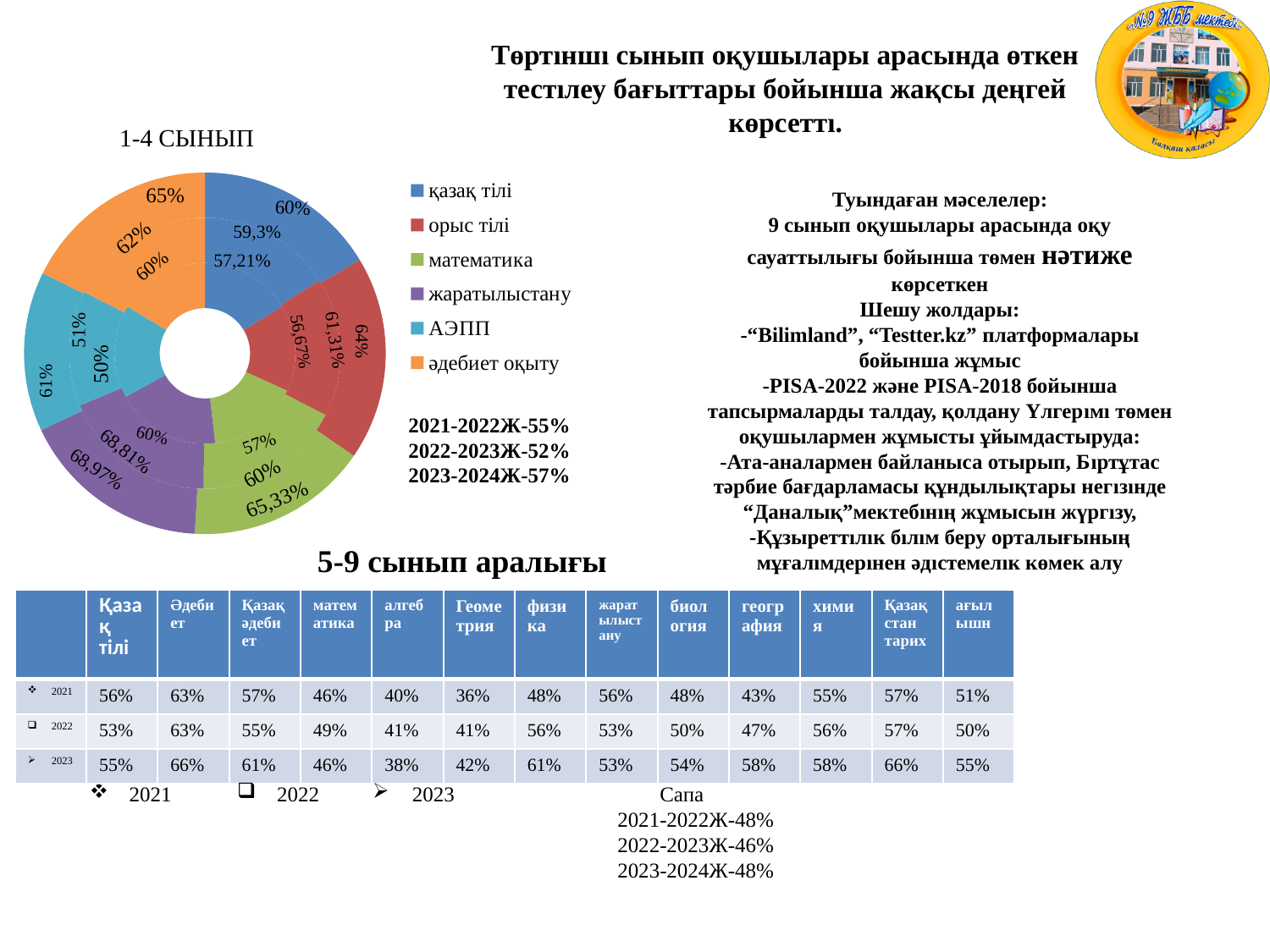
In the '1-4 СЫНЫП' chart, which has the larger outer-ring value: орыс тілі or АЭПП? орыс тілі In the '1-4 СЫНЫП' chart, what is the difference between the outer-ring values for жаратылыстану (68,97%) and қазақ тілі (60%)? 8,97% What kind of chart is the '1-4 СЫНЫП' chart? doughnut chart In the '1-4 СЫНЫП' chart, what is the value shown for қазақ тілі on the innermost ring? 57,21% In the '1-4 СЫНЫП' chart, what is the value shown for орыс тілі on the middle ring? 61,31% How many categories does the legend of the '1-4 СЫНЫП' chart list? 6 In the '1-4 СЫНЫП' chart, which category has the lowest value on the outer ring? қазақ тілі In the '1-4 СЫНЫП' chart, which category has the highest value on the outer ring? жаратылыстану In the '1-4 СЫНЫП' chart, what is the value shown for математика on the outer ring? 65,33% In the '1-4 СЫНЫП' chart, what is the value shown for жаратылыстану on the outer ring? 68,97% In the '1-4 СЫНЫП' chart, what colour represents әдебиет оқыту? orange How many concentric rings does the '1-4 СЫНЫП' doughnut chart have? 3